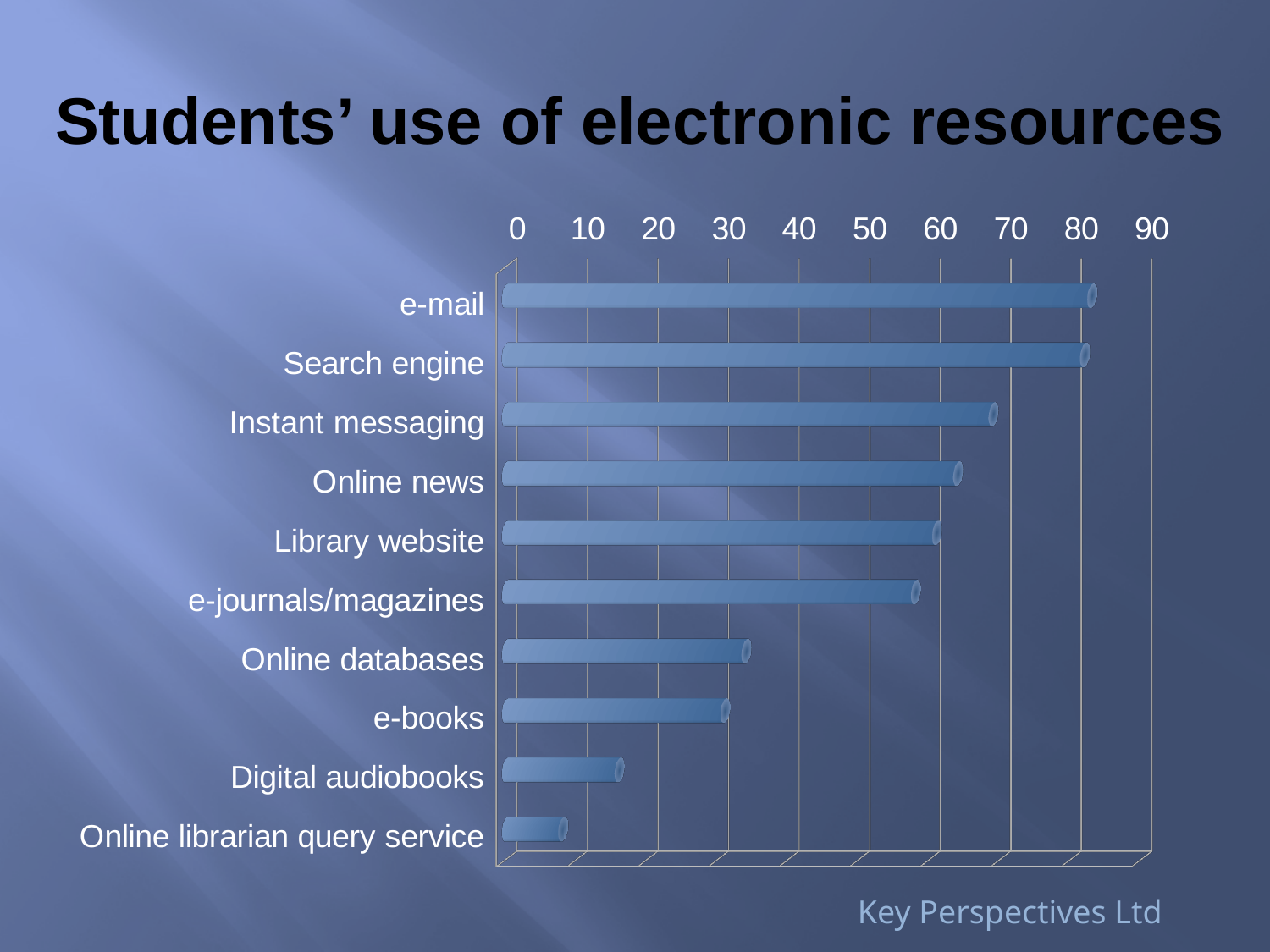
Is the value for Library website greater or less than 50? greater Which category has the lowest value in the chart? Online librarian query service Is the value for Online librarian query service greater or less than 10? less How many categories are plotted in the chart? 10 Which has a larger value, e-books or Digital audiobooks? e-books Which has a larger value, Instant messaging or Online databases? Instant messaging What is the title of the slide containing the chart? Students' use of electronic resources Is the value for Instant messaging greater or less than 60? greater Do the bar values increase or decrease going from the top category to the bottom category? decrease What kind of chart is shown on the slide? bar chart